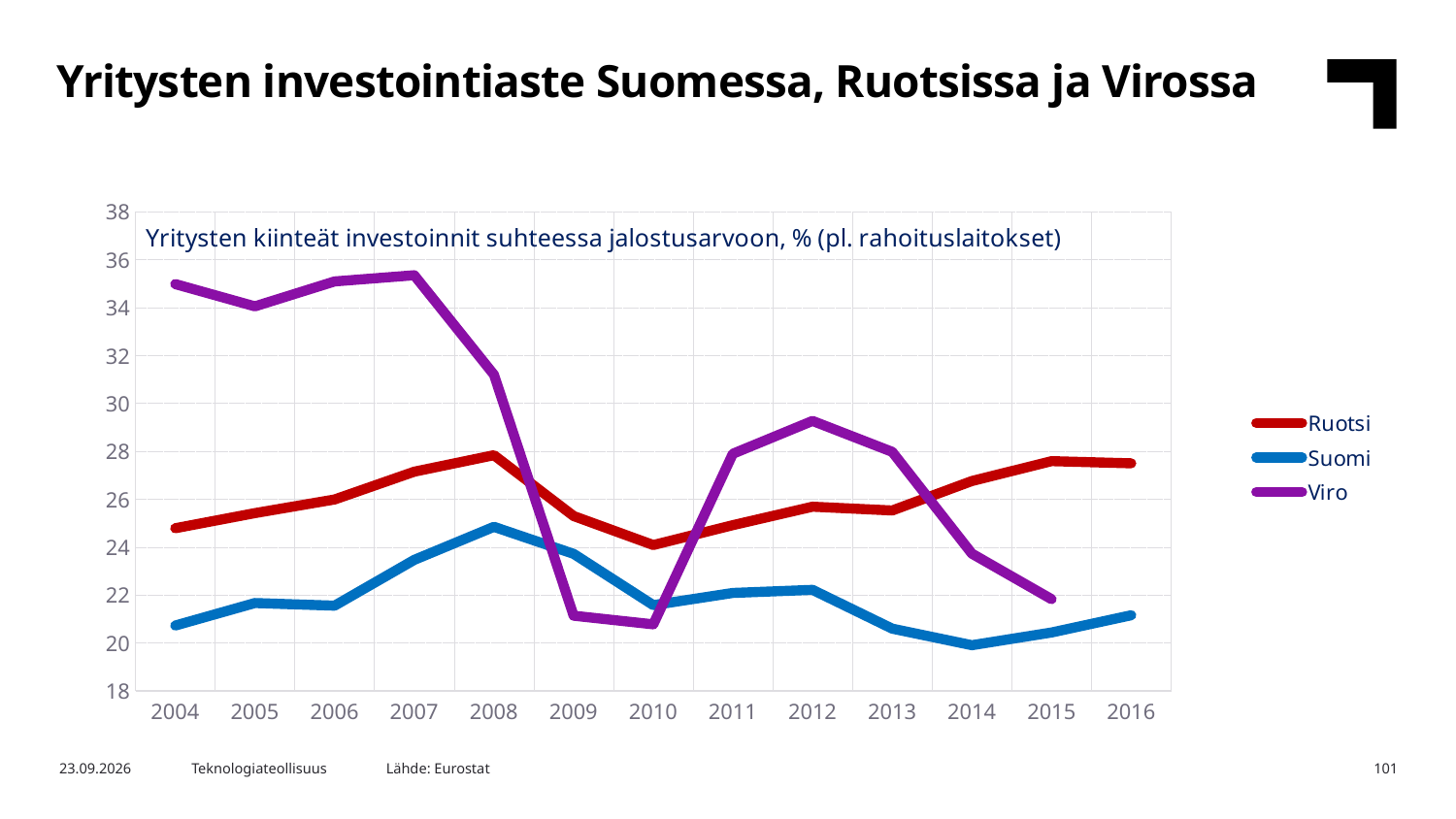
Is the value for Suomi in 2014 greater or less than 22? less How many series does the legend list? 3 In which year is the value for Suomi lowest? 2014 Which series has the highest value in 2006? Viro Which is larger in 2010, the value for Ruotsi or the value for Viro? Ruotsi Is the value for Viro in 2009 greater or less than 22? less Which series does the legend list? Ruotsi, Suomi, Viro Is the value for Ruotsi in 2010 greater or less than 26? less Does the value for Viro rise or fall from 2012 to 2015? fall What kind of chart is shown on the slide? line chart How many years are shown on the x axis? 13